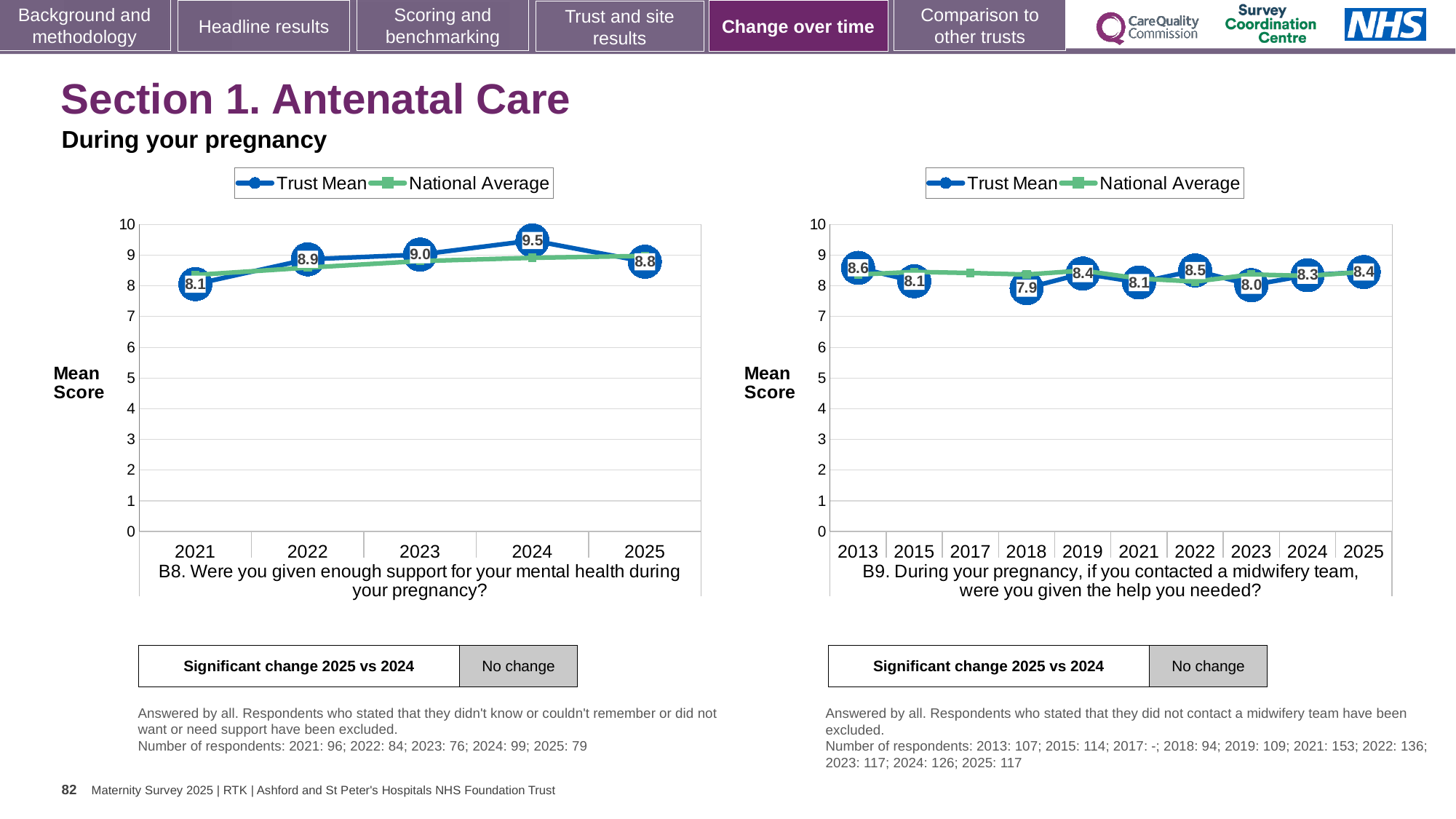
On the B9 chart (right), which year has the lowest Trust Mean? 2018 On the B8 chart (left), what is the difference between the Trust Mean in 2024 and in 2025? 0.7 On the B9 chart (right), which year has the highest Trust Mean? 2013 What type of chart is the B9 chart (right)? Line chart On the B9 chart (right), how many years are shown on the x axis? 10 On the B8 chart (left), which year has the highest Trust Mean? 2024 On the B8 chart (left), how many years are shown on the x axis? 5 On the B8 chart (left), what is the Trust Mean for 2021? 8.1 On the B9 chart (right), is the Trust Mean for 2025 larger or smaller than for 2023? larger On the B8 chart (left), what is the Trust Mean for 2024? 9.5 On the B9 chart (right), what is the Trust Mean for 2018? 7.9 How many series does the legend of the B8 chart (left) list? 2